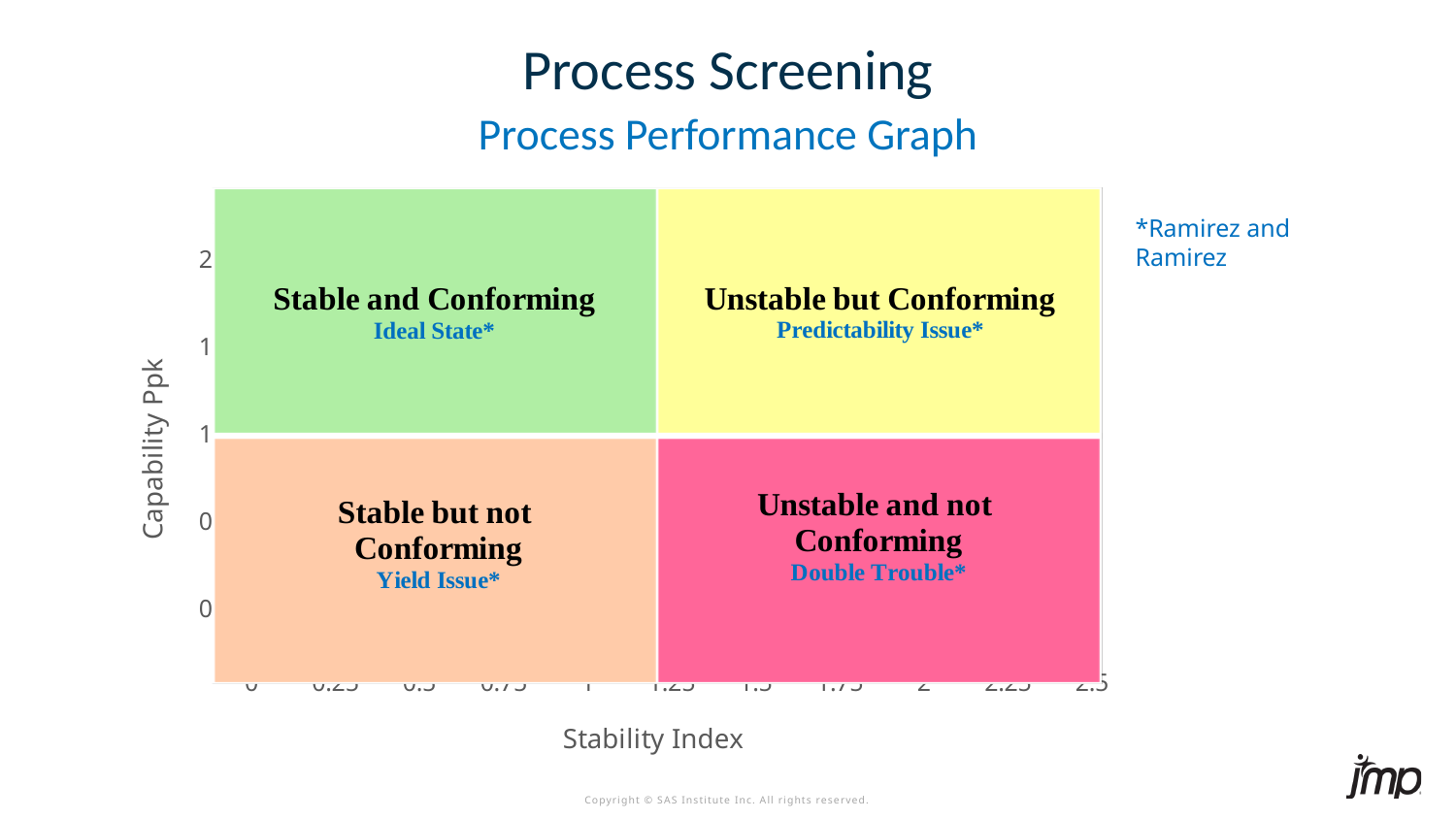
What is the highest tick value shown on the x axis of the chart? 2.5 What is the sub-label shown in the "Stable but not Conforming" quadrant? Yield Issue* What is the label on the x axis of the chart? Stability Index What is the label on the y axis of the chart? Capability Ppk What is the sub-label shown in the "Unstable and not Conforming" quadrant? Double Trouble* How many coloured regions (quadrants) does the chart contain? 4 What is the sub-label shown in the "Unstable but Conforming" quadrant? Predictability Issue* Which quadrant is labelled "Predictability Issue*"? Unstable but Conforming Which quadrant of the chart is described as the "Ideal State*"? Stable and Conforming